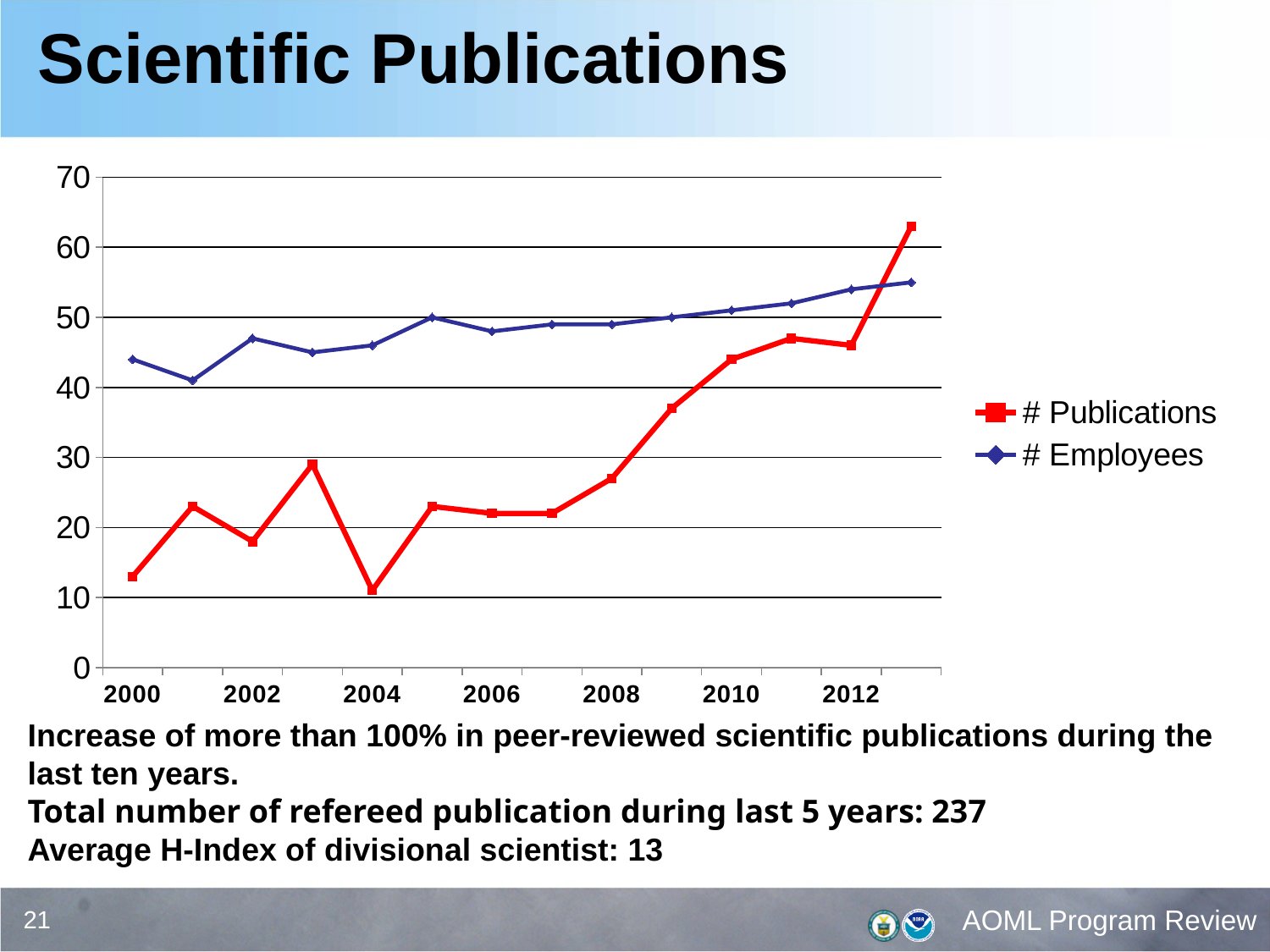
In 2010, which series has the larger value, # Publications or # Employees? # Employees What kind of chart is shown on the slide? line chart Is the # Publications value for 2013 greater or less than 60? greater How many years are plotted along the x axis for each series? 14 In 2013, which series has the larger value, # Publications or # Employees? # Publications Does the # Employees series generally rise or fall from 2000 to 2013? rise In which year is the # Employees value lowest? 2001 In which year is the # Publications value highest? 2013 How many series does the legend list? 2 Is the # Employees value for 2000 greater or less than 40? greater What are the two series named in the legend? # Publications and # Employees Is the # Publications value for 2004 greater or less than 20? less